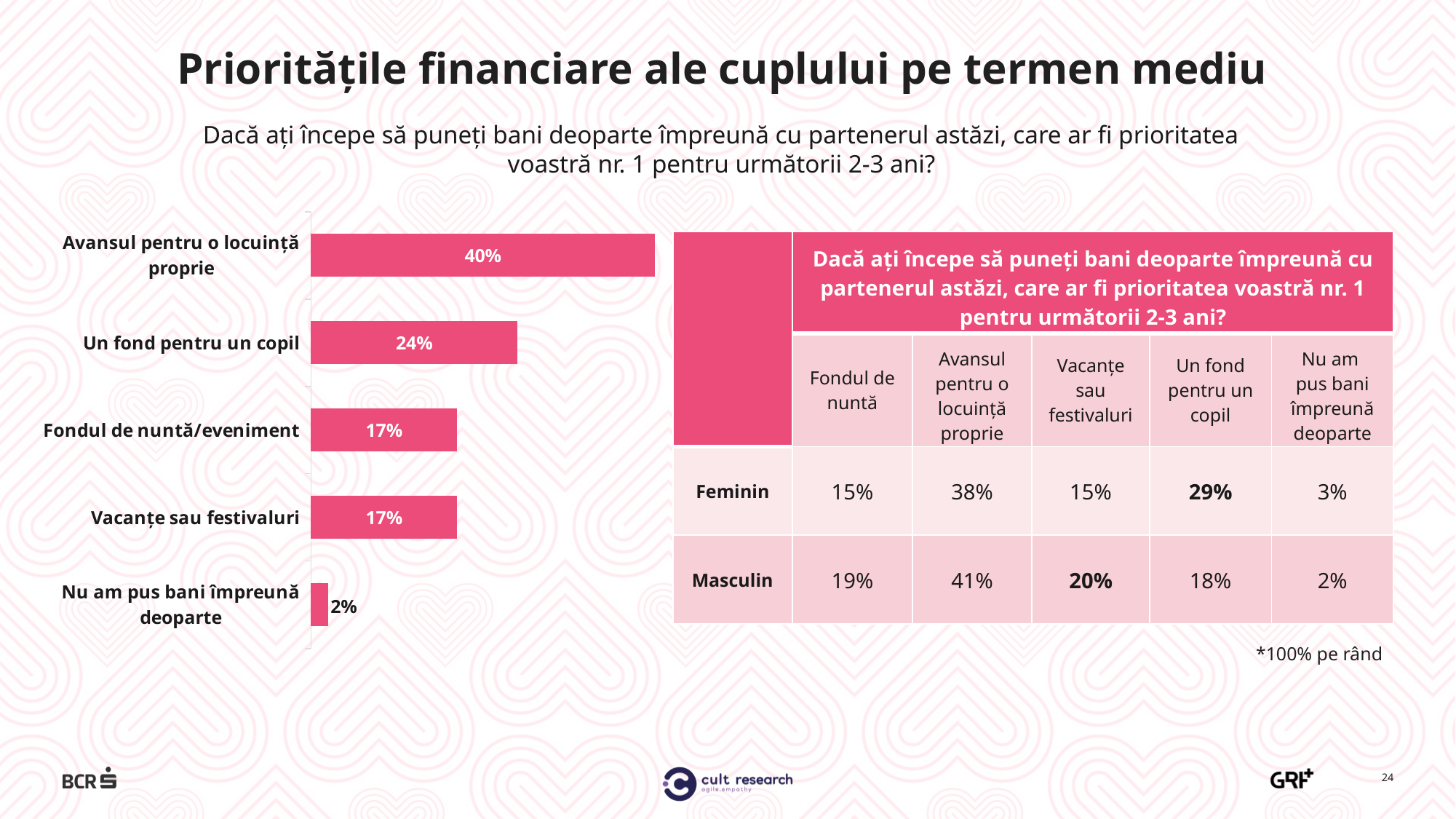
What is the value for "Avansul pentru o locuință proprie" in the bar chart? 40% Which is larger in the bar chart: "Un fond pentru un copil" or "Fondul de nuntă/eveniment"? Un fond pentru un copil What kind of chart is shown on the left of the slide? Bar chart What is the value for "Un fond pentru un copil" in the bar chart? 24% What is the value for "Nu am pus bani împreună deoparte" in the bar chart? 2% Which category has the highest value in the bar chart? Avansul pentru o locuință proprie Which category has the lowest value in the bar chart? Nu am pus bani împreună deoparte How many categories are shown in the bar chart? 5 What is the value for "Vacanțe sau festivaluri" in the bar chart? 17% Are the bars in the bar chart oriented horizontally or vertically? Horizontally What is the difference between the values for "Fondul de nuntă/eveniment" and "Nu am pus bani împreună deoparte" in the bar chart? 15% What is the difference between the values for "Avansul pentru o locuință proprie" and "Un fond pentru un copil" in the bar chart? 16%